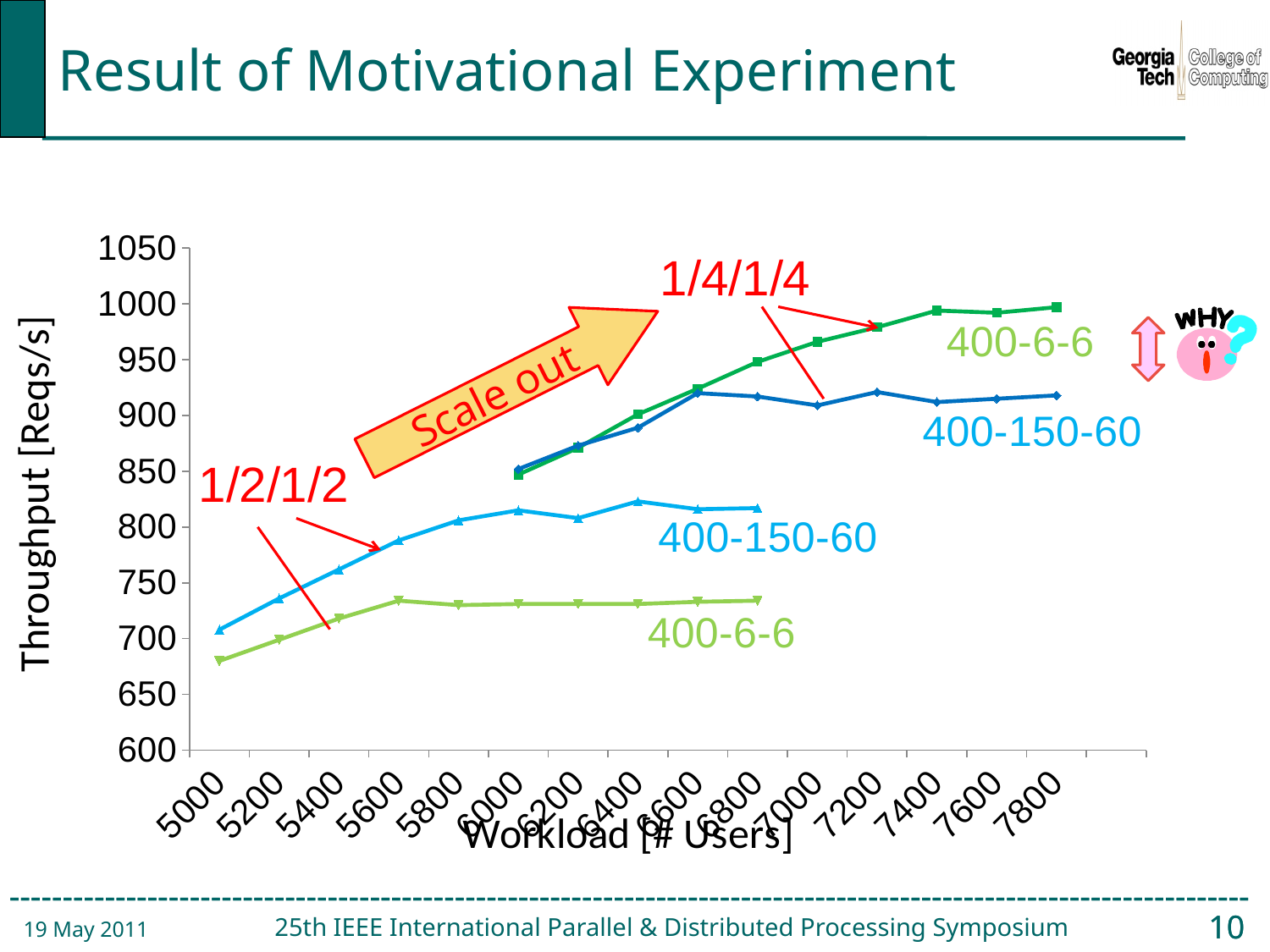
Is the throughput of the 1/2/1/2 400-6-6 line at a workload of 5000 users greater or less than 700? less In the 1/2/1/2 configuration, which line has the higher throughput at a workload of 6800 users, 400-6-6 or 400-150-60? 400-150-60 How many workload values are labeled on the horizontal axis of the chart? 15 What is the highest value shown on the vertical axis of the chart? 1050 What is the label of the vertical axis of the chart? Throughput [Reqs/s] Is the throughput of the 1/4/1/4 400-6-6 line at a workload of 7800 users greater or less than 950? greater What is the label of the horizontal axis of the chart? Workload [# Users] Does the 1/2/1/2 400-6-6 line rise or fall as the workload increases from 5000 to 5600 users? rise Is the throughput of the 1/2/1/2 400-150-60 line at a workload of 6800 users greater or less than 800? greater In the 1/4/1/4 configuration, which line has the higher throughput at a workload of 7800 users, 400-6-6 or 400-150-60? 400-6-6 What kind of chart is shown on the slide? line chart